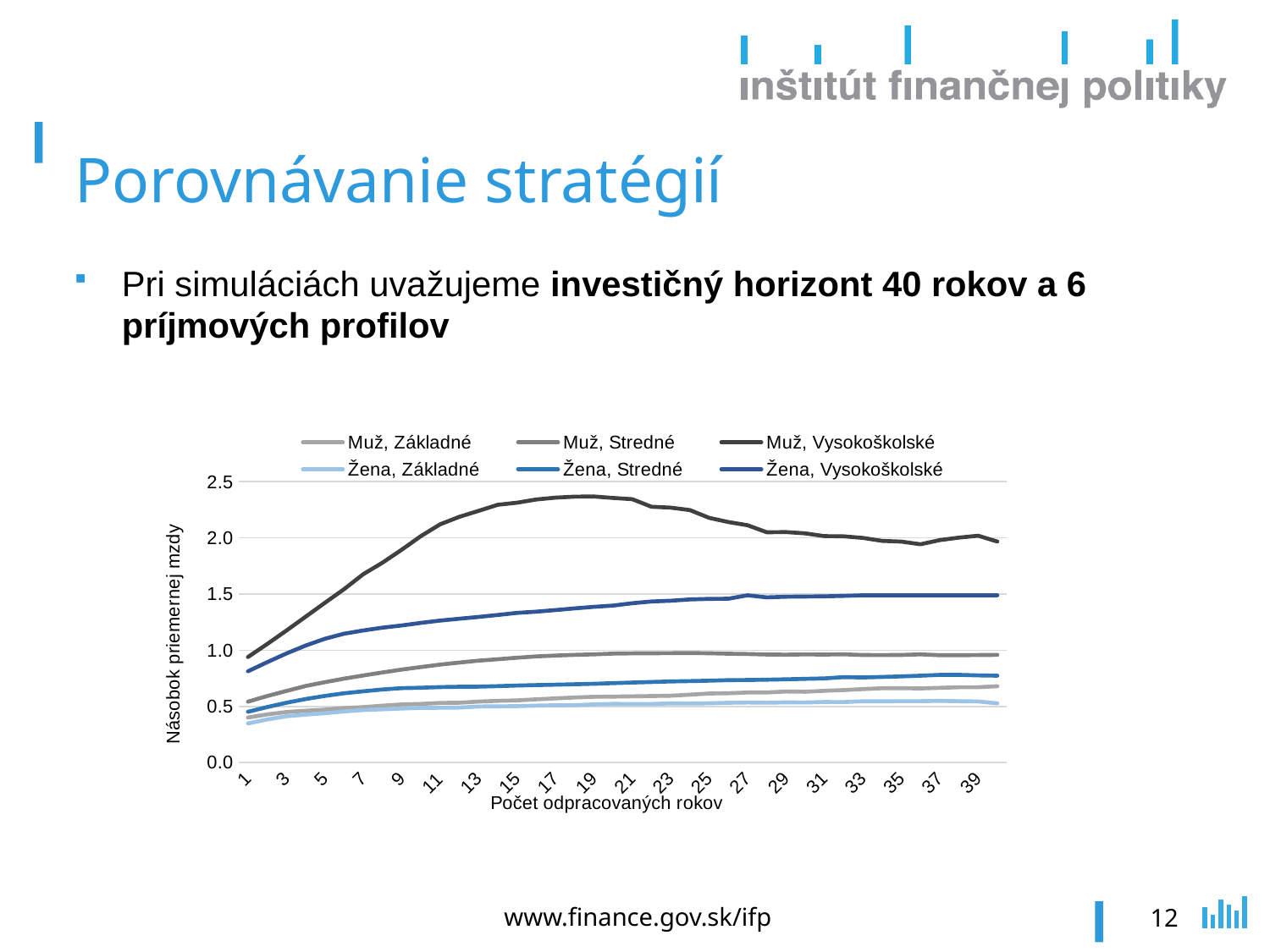
Is the value for Muž, Stredné at year 39 greater or less than 1.0? less Which series has the lowest values on the chart? Žena, Základné What kind of chart is shown on the slide? line chart How many series does the chart's legend list? 6 Does the Žena, Vysokoškolské series rise or fall between year 1 and year 27? rise Which series reaches the highest value on the chart? Muž, Vysokoškolské What is the label of the vertical axis of the chart? Násobok priemernej mzdy What is the label of the horizontal axis of the chart? Počet odpracovaných rokov Is the value for Žena, Vysokoškolské at year 39 greater or less than 1.0? greater At year 39, which series is higher: Muž, Stredné or Žena, Stredné? Muž, Stredné Is the value for Muž, Vysokoškolské at year 19 greater or less than 2.0? greater